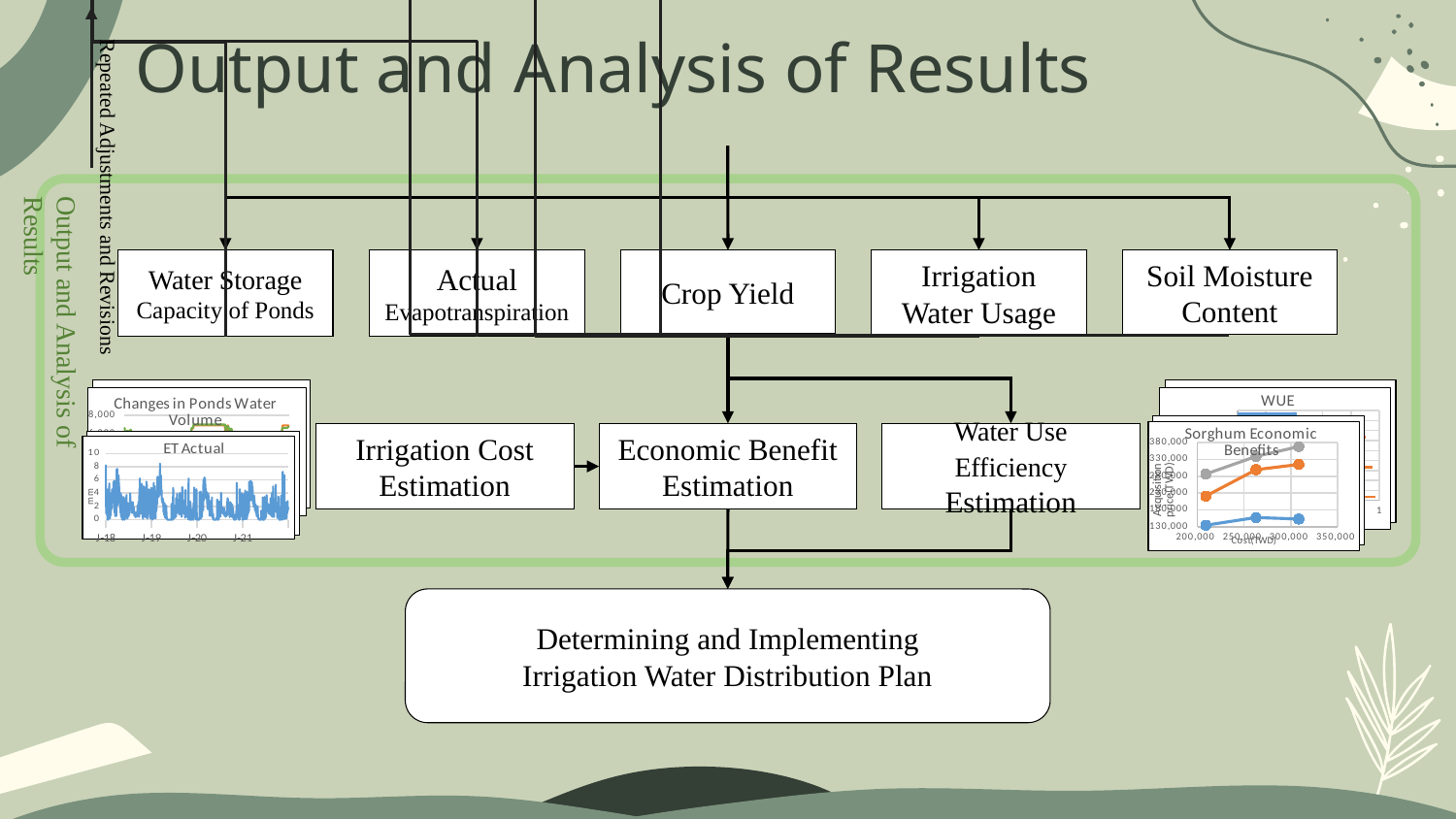
On the 'Sorghum Economic Benefits' chart, are the values of the blue line greater or less than 180,000? less What is the highest tick value shown on the y axis of the 'ET Actual' chart? 10 What is the lowest tick value shown on the x axis of the 'Sorghum Economic Benefits' chart? 200,000 How many lines are plotted on the 'Sorghum Economic Benefits' chart? 3 On the 'Sorghum Economic Benefits' chart, does the orange line rise or fall as cost increases along the x axis? rise What is the x-axis title of the 'Sorghum Economic Benefits' chart? Cost(Twd) On the 'Sorghum Economic Benefits' chart, which line has the highest values, the gray line or the blue line? gray line How many year labels (J-18 to J-21) are shown on the x axis of the 'ET Actual' chart? 4 What is the title of the chart in the lower-left area of the slide that shows values over J-18 to J-21? ET Actual On the 'Sorghum Economic Benefits' chart, does the gray line rise or fall as cost increases along the x axis? rise What kind of chart is the 'ET Actual' chart? line chart What kind of chart is the 'Sorghum Economic Benefits' chart? line chart